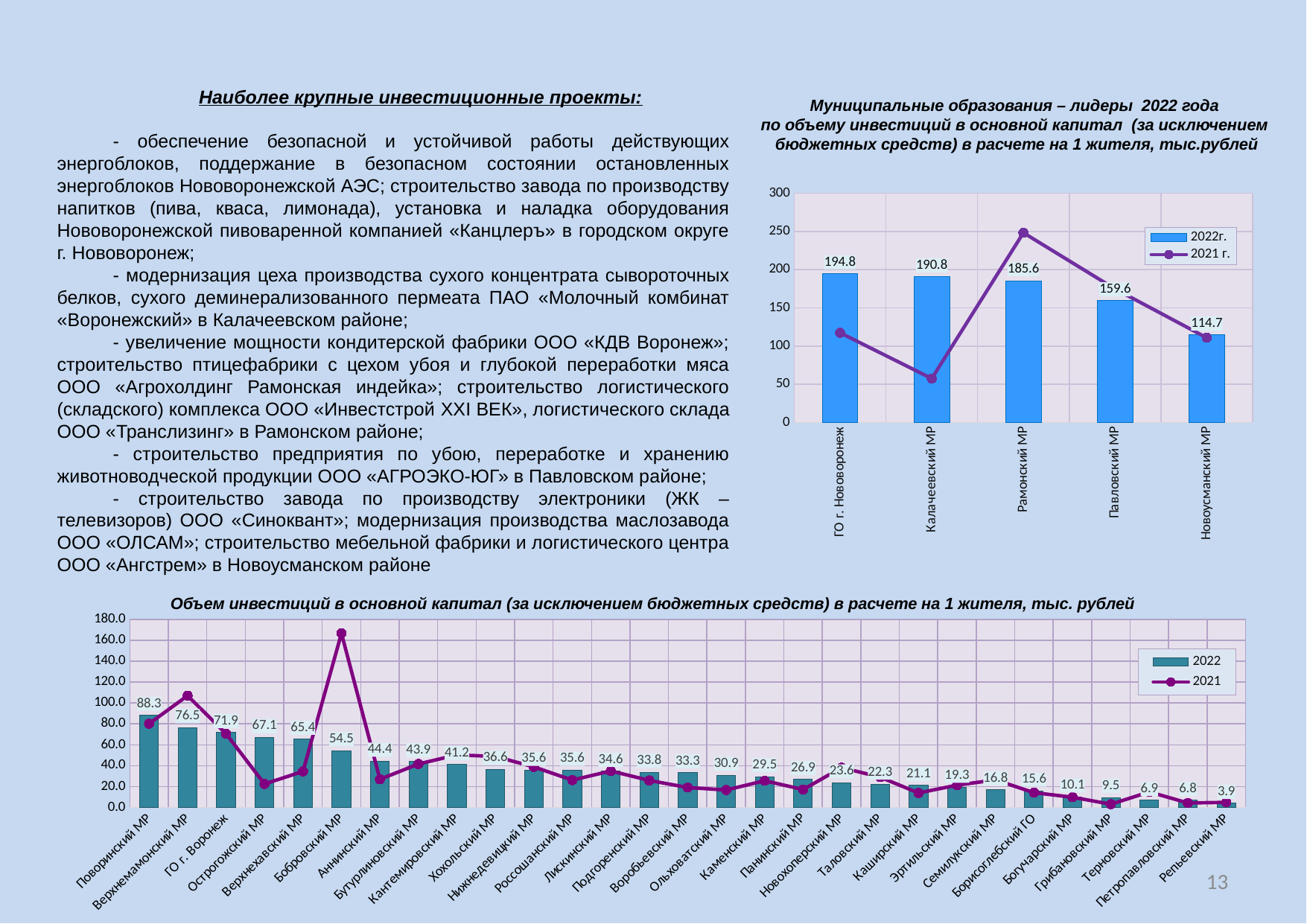
In the bottom chart (Объем инвестиций в основной капитал), how many municipalities are shown on the x axis? 29 In the top-right chart (Муниципальные образования – лидеры 2022 года), how many series does the legend list? 2 In the top-right chart (Муниципальные образования – лидеры 2022 года), what is the difference between the 2022 values for ГО г. Нововоронеж and Павловский МР? 35.2 In the top-right chart (Муниципальные образования – лидеры 2022 года), which municipality has the highest 2022 bar? ГО г. Нововоронеж In the top-right chart (Муниципальные образования – лидеры 2022 года), what is the 2022 value for Рамонский МР? 185.6 In the bottom chart (Объем инвестиций в основной капитал), is the 2021 value for Бобровский МР greater or less than 140.0? greater In the bottom chart (Объем инвестиций в основной капитал), which is larger for 2022: Аннинский МР or Каменский МР? Аннинский МР In the bottom chart (Объем инвестиций в основной капитал), which municipality has the lowest 2022 bar? Репьевский МР In the top-right chart (Муниципальные образования – лидеры 2022 года), which municipality has the lowest 2022 bar? Новоусманский МР In the bottom chart (Объем инвестиций в основной капитал), what is the 2022 value for Бобровский МР? 54.5 In the bottom chart (Объем инвестиций в основной капитал), which municipality has the highest 2022 bar? Поворинский МР In the top-right chart (Муниципальные образования – лидеры 2022 года), is the 2021 value for Рамонский МР greater or less than 200? greater